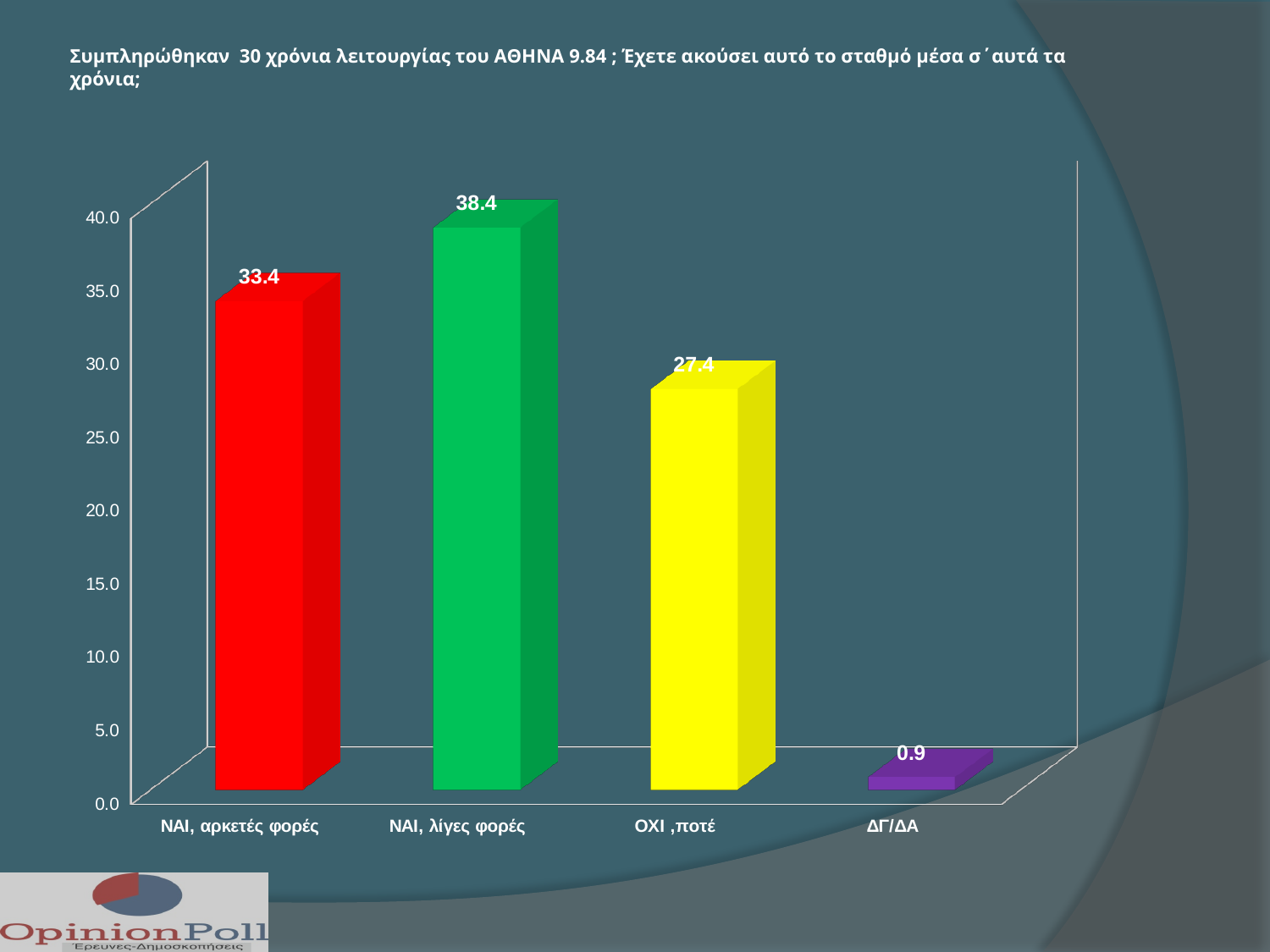
Which category has the lowest value? ΔΓ/ΔΑ What is the difference between the values for "ΝΑΙ, λίγες φορές" and "ΝΑΙ, αρκετές φορές"? 5.0 What is the value for "ΔΓ/ΔΑ"? 0.9 Which category has the highest value? ΝΑΙ, λίγες φορές What is the value for "ΟΧΙ ,ποτέ"? 27.4 What is the value for "ΝΑΙ, αρκετές φορές"? 33.4 What colour is the bar for "ΟΧΙ ,ποτέ"? yellow Which is larger, the value for "ΝΑΙ, αρκετές φορές" or the value for "ΟΧΙ ,ποτέ"? ΝΑΙ, αρκετές φορές How many categories are shown on the chart? 4 What is the value for "ΝΑΙ, λίγες φορές"? 38.4 Is the value for "ΟΧΙ ,ποτέ" greater or less than 30.0? less What kind of chart is shown on the slide? bar chart